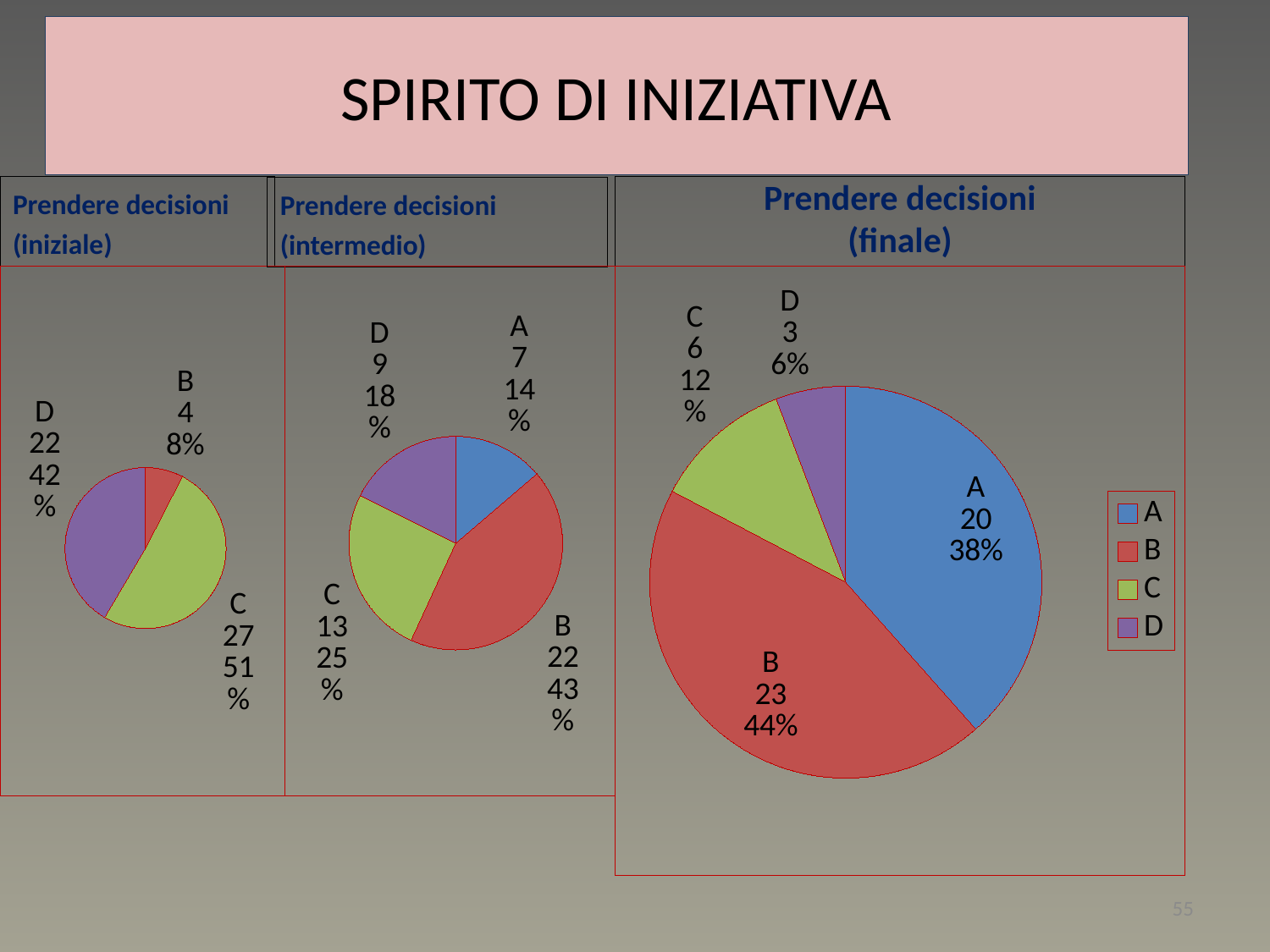
In the 'Prendere decisioni (intermedio)' chart, which category has the largest slice? B In the 'Prendere decisioni (iniziale)' chart, what is the value for category D? 22 In the 'Prendere decisioni (intermedio)' chart, what is the value for category C? 13 In the 'Prendere decisioni (finale)' chart, what is the difference between the values for B and A? 3 In the 'Prendere decisioni (finale)' chart, what percentage share does category A have? 38% In the 'Prendere decisioni (iniziale)' chart, which category has the largest slice? C In the 'Prendere decisioni (finale)' chart, which category has the smallest slice? D How many entries does the legend of the 'Prendere decisioni (finale)' chart list? 4 In the 'Prendere decisioni (finale)' chart, what is the value for category B? 23 In the 'Prendere decisioni (iniziale)' chart, which is larger, the value for B or the value for D? D In the 'Prendere decisioni (intermedio)' chart, what percentage share does category D have? 18% What kind of chart is used for 'Prendere decisioni (finale)'? Pie chart